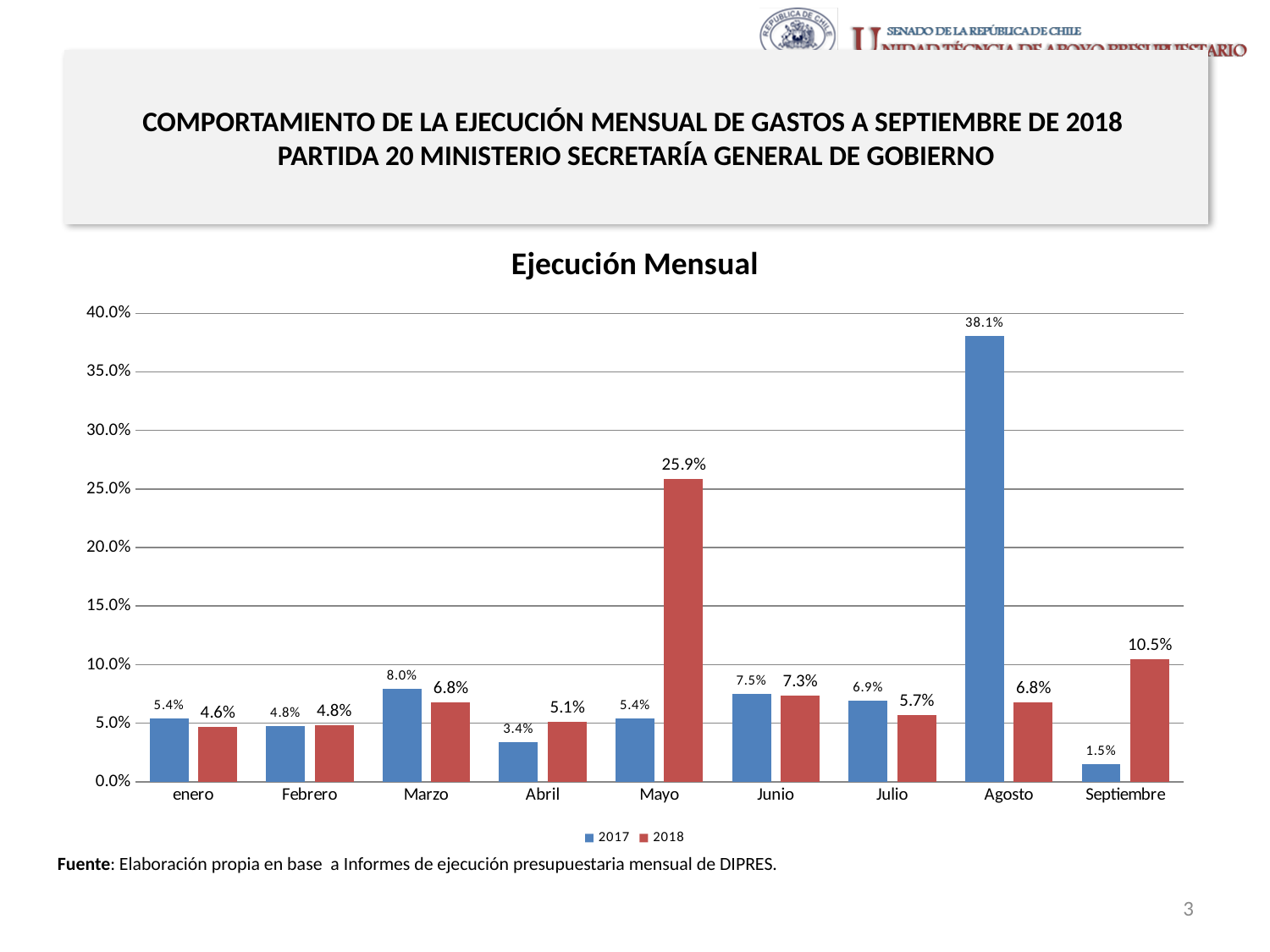
Which month has the highest 2018 value? Mayo How many months are shown on the x axis? 9 What is the difference between the 2018 and 2017 values for Mayo? 20.5% Which is larger for Septiembre, the 2017 value or the 2018 value? 2018 What is the 2017 value for Abril? 3.4% What is the 2018 value for Septiembre? 10.5% What type of chart is shown? Bar chart Which month has the lowest 2017 value? Septiembre What is the 2017 value for Agosto? 38.1% What is the 2018 value for Mayo? 25.9% Which month has the highest 2017 value? Agosto How many series does the legend list? 2